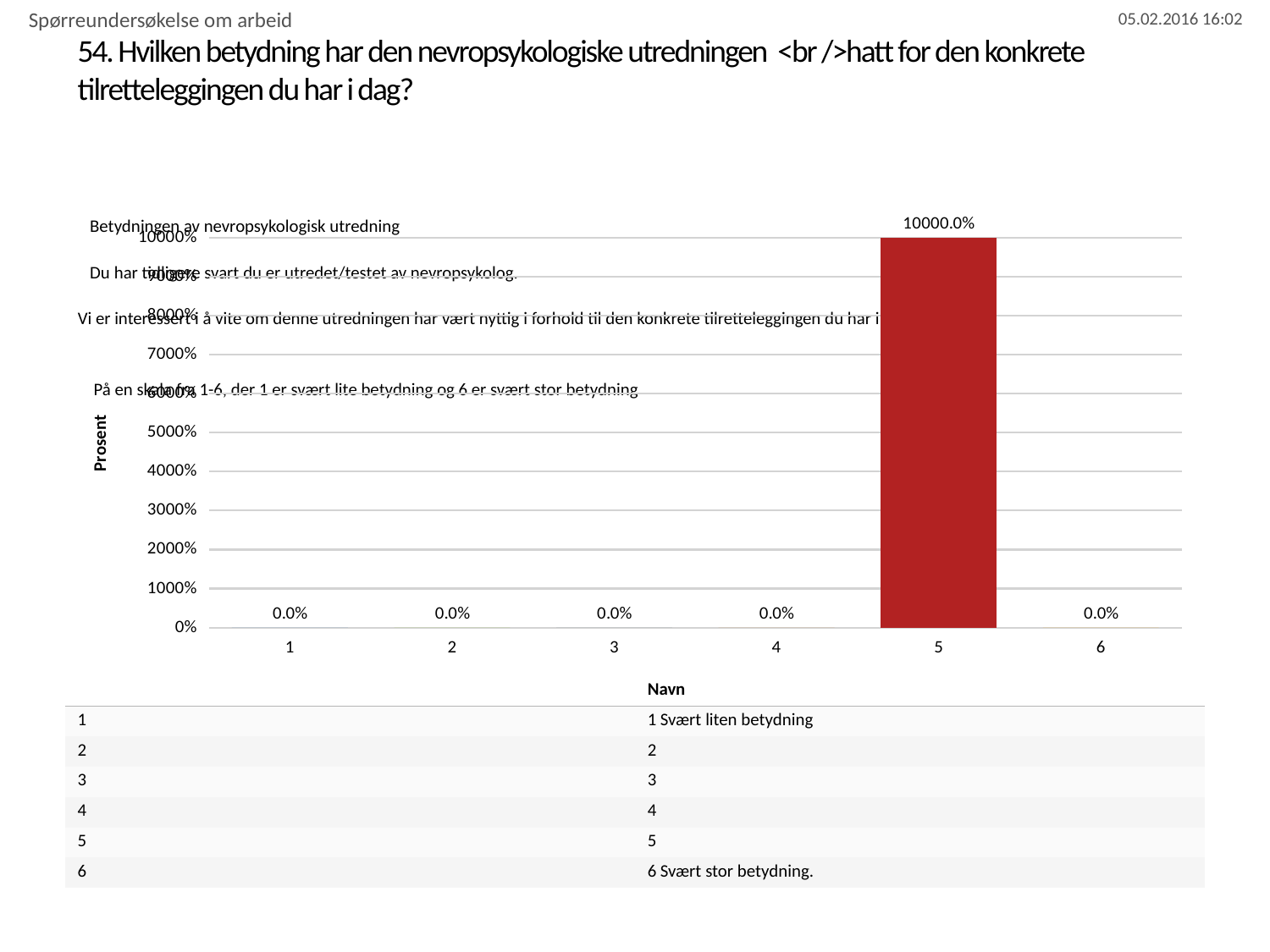
What is the difference between the values for category 5 and category 4? 10000.0% How many categories are shown on the x axis of the chart? 6 Which category has the highest value in the chart? 5 What is the value for category 6 in the chart? 0.0% What is the value for category 5 in the chart? 10000.0% What type of chart is shown on the slide? bar chart Is the value for category 5 greater or less than 5000%? greater What colour is the bar for category 5? red Which is larger, the value for category 5 or the value for category 3? 5 How many categories in the chart have a value of 0.0%? 5 What is the value for category 1 in the chart? 0.0% What is the label of the y axis of the chart? Prosent